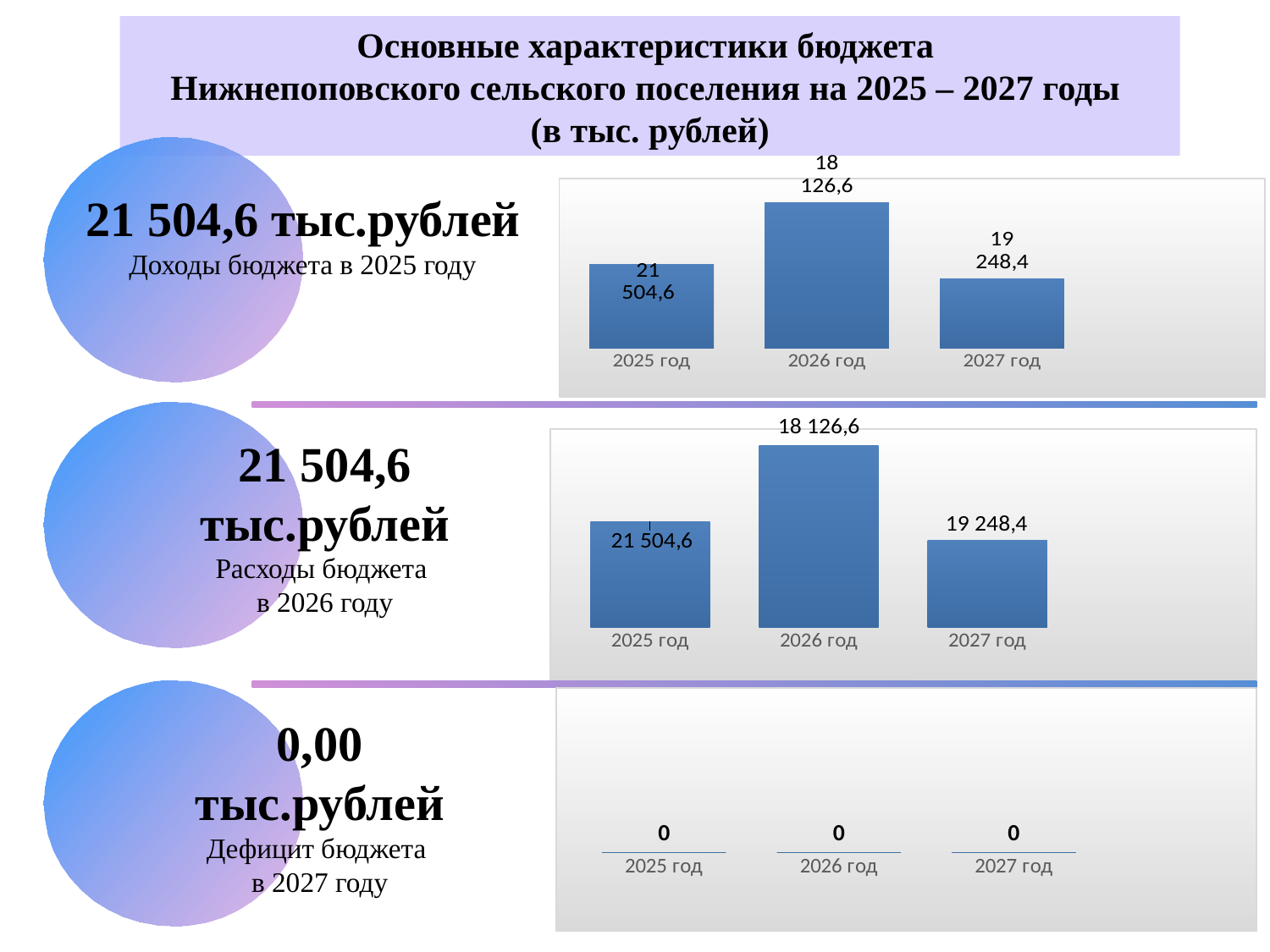
In the bottom chart, what is the value for 2026 год? 0 How many categories are shown in the top chart? 3 What kind of chart is the middle chart? bar chart In the top chart, what is the value for 2026 год? 18 126,6 In the top chart, what is the value for 2027 год? 19 248,4 In the top chart, what is the difference between the values for 2025 год and 2026 год? 3 378,0 In the middle chart, what is the difference between the values for 2025 год and 2027 год? 2 256,2 How many categories are shown in the bottom chart? 3 What is the title of the slide containing the charts? Основные характеристики бюджета Нижнепоповского сельского поселения на 2025 – 2027 годы (в тыс. рублей) In the top chart, what is the value for 2025 год? 21 504,6 In the middle chart, what is the value for 2027 год? 19 248,4 In the middle chart, what is the value for 2025 год? 21 504,6